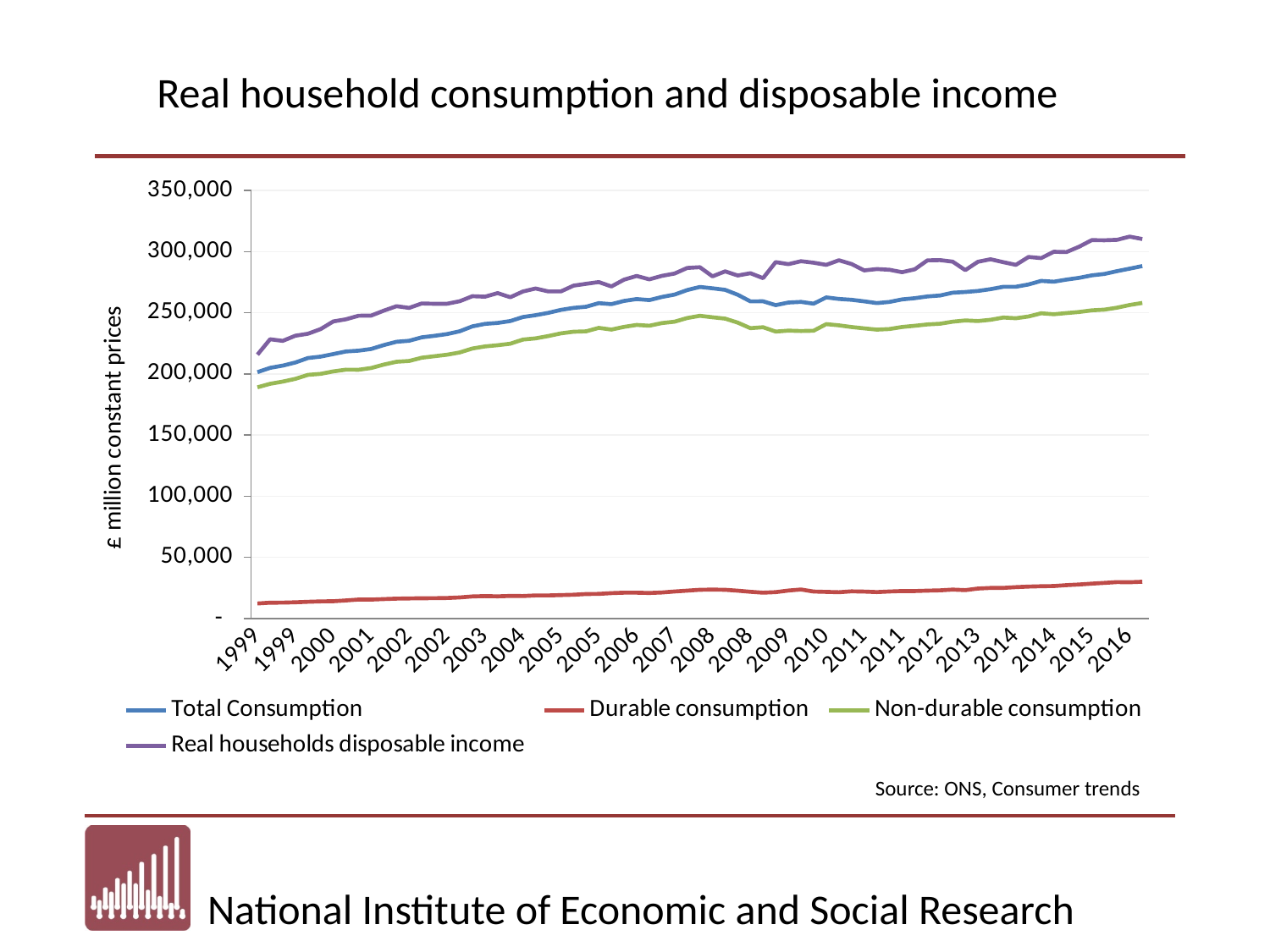
Which series has the highest values across the chart? Real households disposable income How many series does the legend list? 4 Which is larger throughout the chart, Total Consumption or Non-durable consumption? Total Consumption Is the value for Real households disposable income in 2016 greater or less than 300,000? greater Does Total Consumption rise or fall overall from 1999 to 2016? rise What is the label on the vertical axis? £ million constant prices Does Real households disposable income rise or fall overall from 1999 to 2016? rise What kind of chart is shown on the slide? line chart Which series has the lowest values across the chart? Durable consumption What is the title of the chart? Real household consumption and disposable income Is the value for Durable consumption in 2016 greater or less than 50,000? less Is the value for Total Consumption in 1999 greater or less than 250,000? less